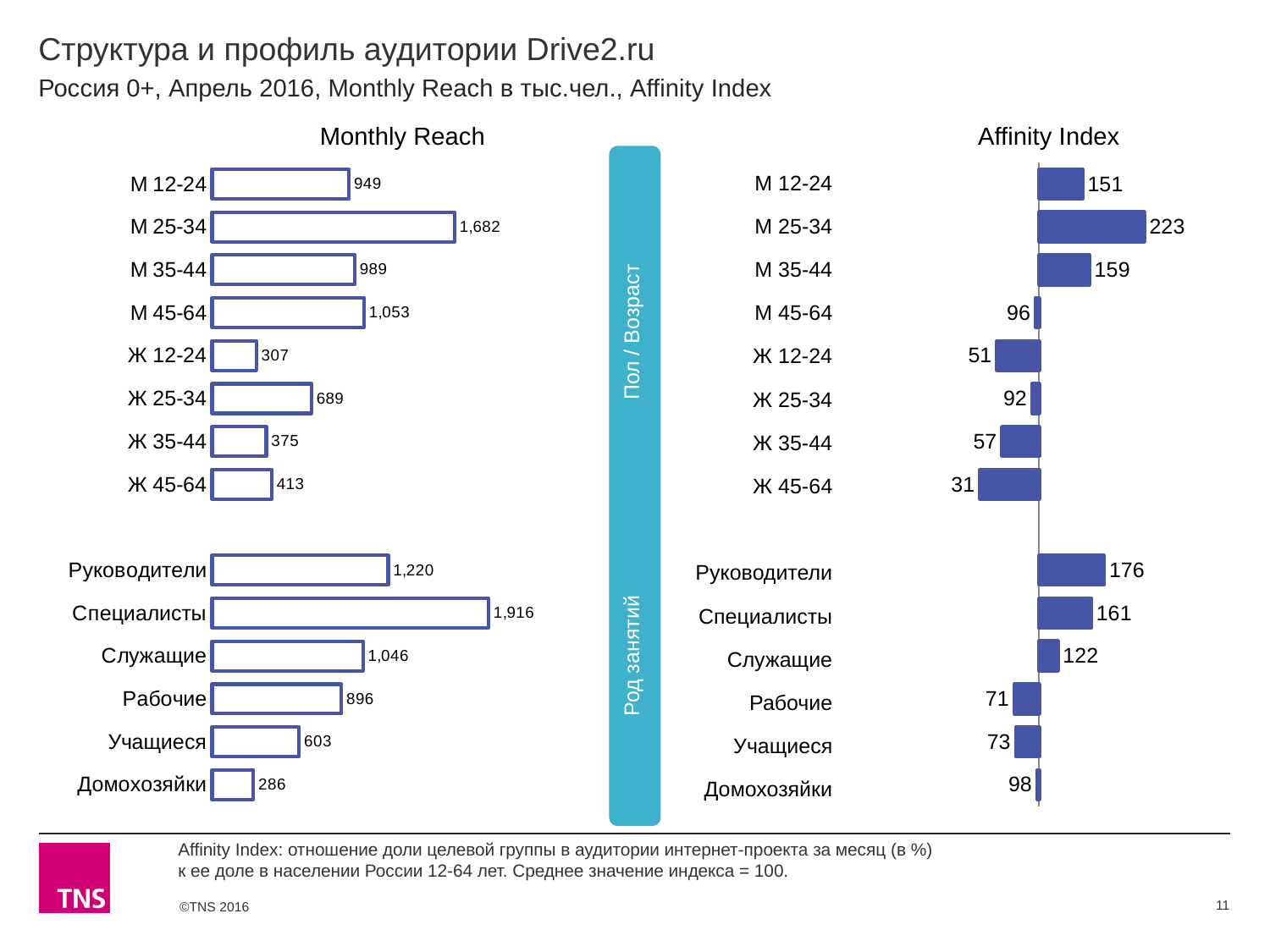
In the Affinity Index chart, which category has the highest value? М 25-34 In the Affinity Index chart, what is the value for Ж 45-64? 31 In the Monthly Reach chart, what is the difference between Специалисты and Руководители? 696 What kind of chart is the Monthly Reach chart? Bar chart In the Monthly Reach chart, what is the value for М 25-34? 1,682 How many categories are shown in the Affinity Index chart? 14 In the Affinity Index chart, which category has the lowest value? Ж 45-64 In the Monthly Reach chart, what is the value for Домохозяйки? 286 In the Affinity Index chart, what is the difference between М 25-34 and М 12-24? 72 In the Monthly Reach chart, which is larger: М 45-64 or Служащие? М 45-64 In the Monthly Reach chart, which category has the highest value? Специалисты In the Affinity Index chart, what is the value for Руководители? 176